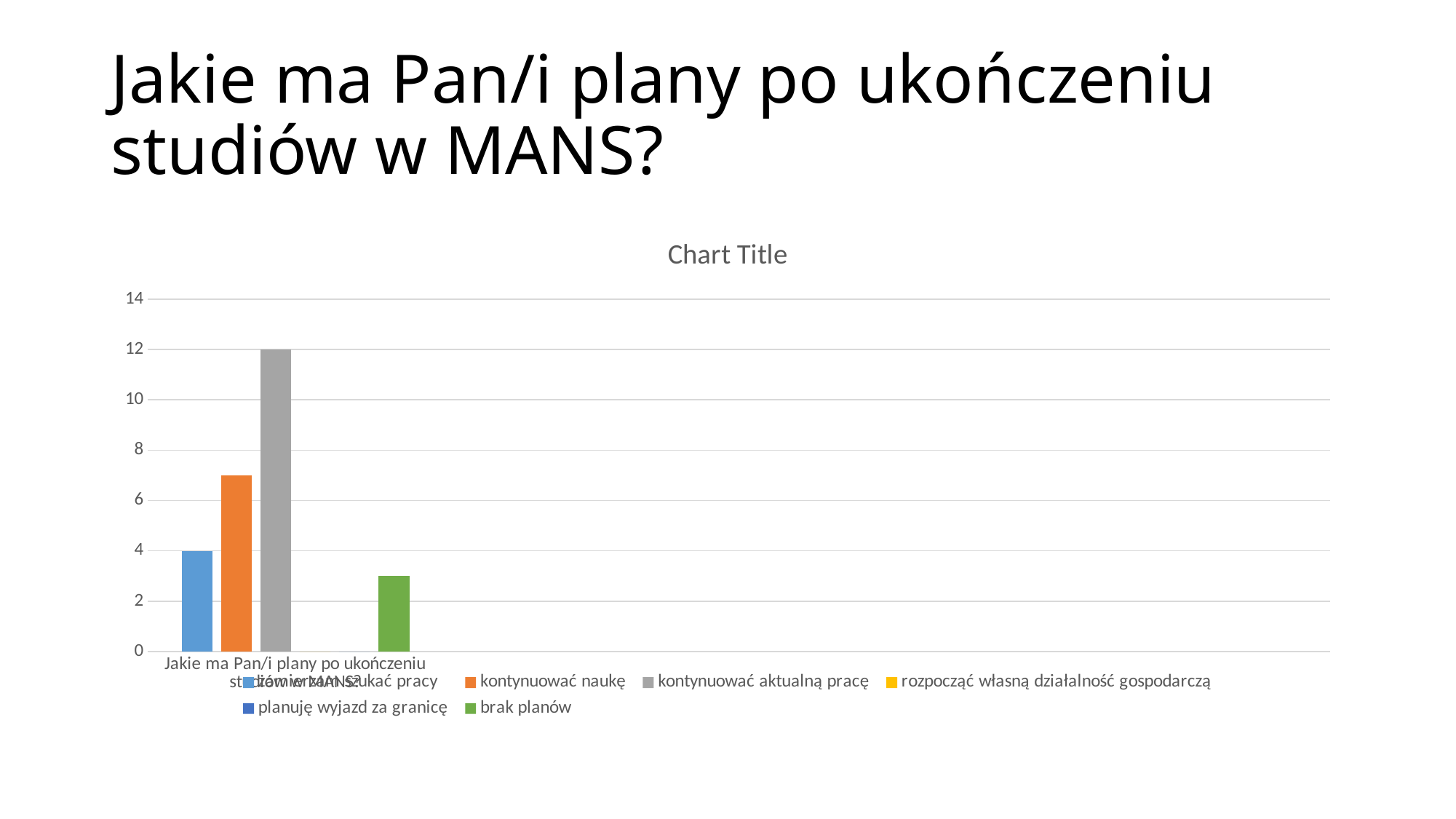
What is the value for "zamierzam szukać pracy"? 4 How many series does the chart legend list? 6 What colour is the bar for "kontynuować aktualną pracę"? gray What is the title shown above the chart? Chart Title What kind of chart is shown on the slide? bar chart Is the value for "brak planów" greater or less than 4? less Is the value for "kontynuować naukę" greater or less than 6? greater Which series has the highest value in the chart? kontynuować aktualną pracę Is the value for "kontynuować naukę" greater or less than 8? less What is the difference between the values for "kontynuować aktualną pracę" and "zamierzam szukać pracy"? 8 What is the value for "kontynuować aktualną pracę"? 12 Which is larger, the value for "kontynuować naukę" or the value for "brak planów"? kontynuować naukę